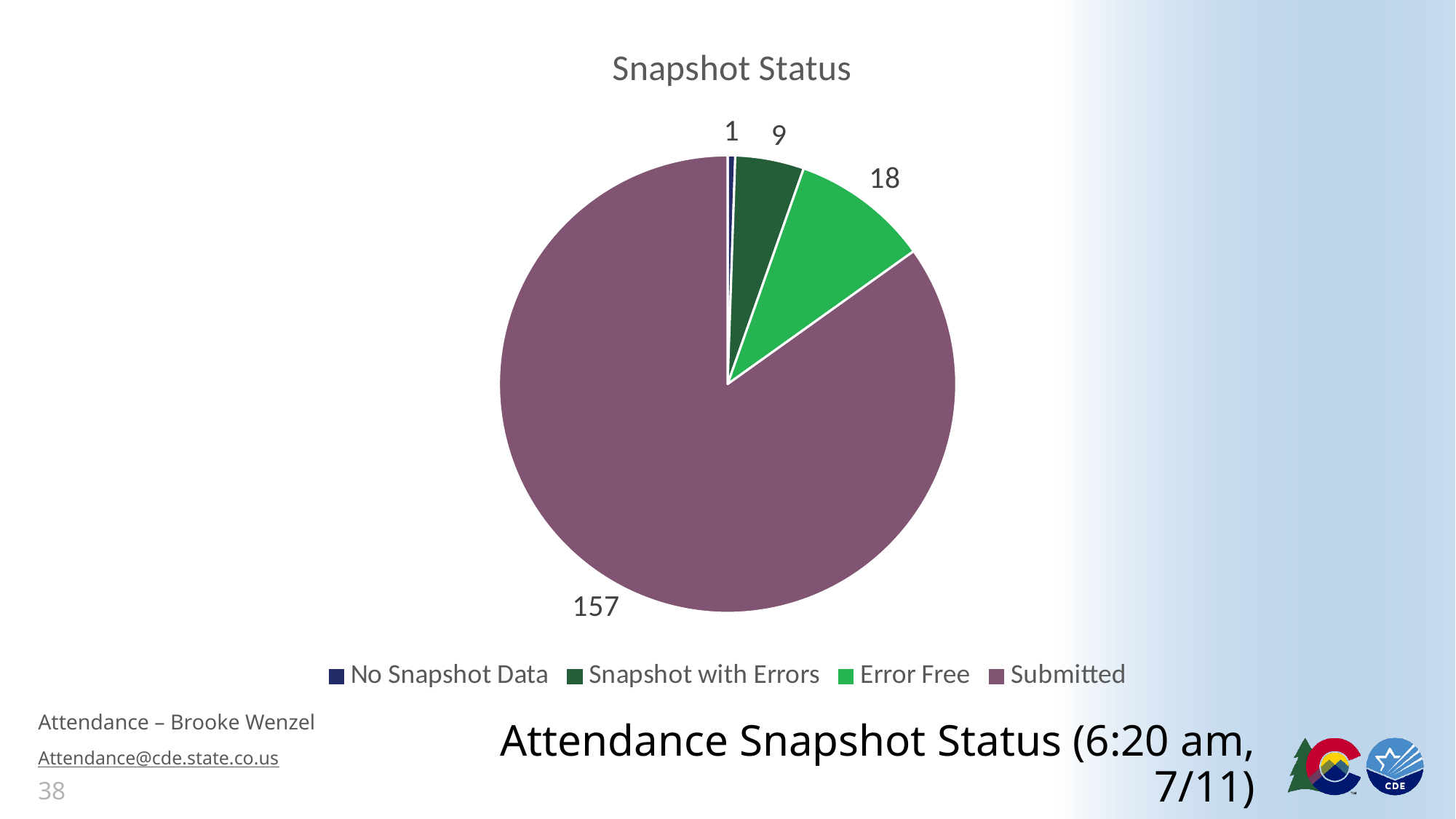
What is the difference between the Submitted value and the Error Free value? 139 What type of chart is shown on the slide? pie chart What is the value for No Snapshot Data? 1 What is the value for Error Free? 18 Which category has the smallest slice? No Snapshot Data How many slices does the pie chart have? 4 What is the title of the chart? Snapshot Status What is the value for Submitted? 157 Which is larger, Error Free or Snapshot with Errors? Error Free What is the value for Snapshot with Errors? 9 Which category has the largest slice? Submitted What is the total of all slices in the pie chart? 185